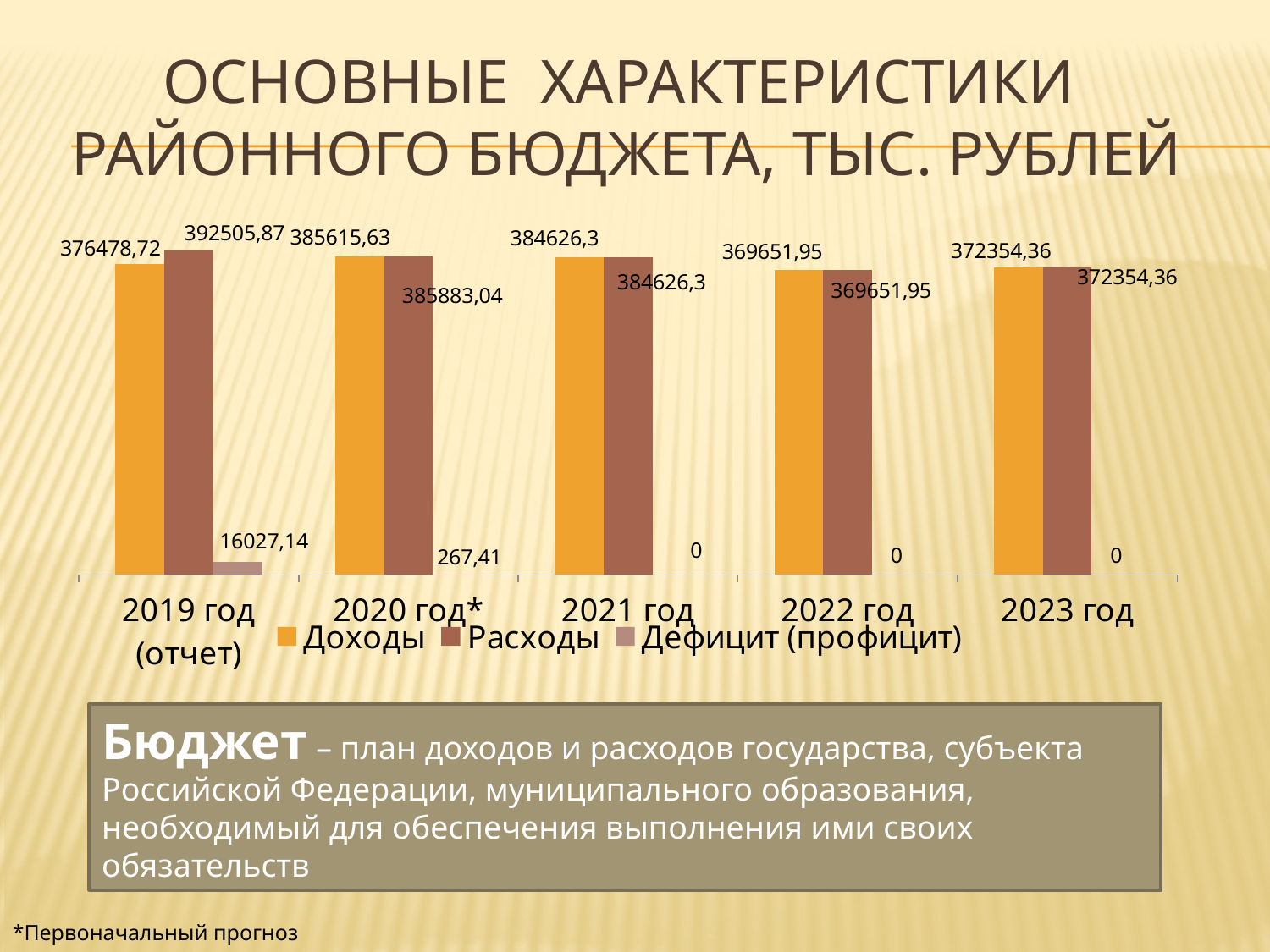
What is the difference between Расходы and Доходы for 2020 год*? 267,41 What is the value of Дефицит (профицит) for 2019 год (отчет)? 16027,14 In which year is Расходы the highest? 2019 год (отчет) What is the value of Расходы for 2020 год*? 385883,04 In which year is Доходы the lowest? 2022 год How many series does the legend list? 3 What is the value of Доходы for 2022 год? 369651,95 Does Доходы rise or fall from 2020 год* to 2022 год? Fall For 2019 год (отчет), which is larger: Доходы or Расходы? Расходы How many years are shown on the x axis? 5 What kind of chart is shown on the slide? Bar chart What is the value of Доходы for 2019 год (отчет)? 376478,72